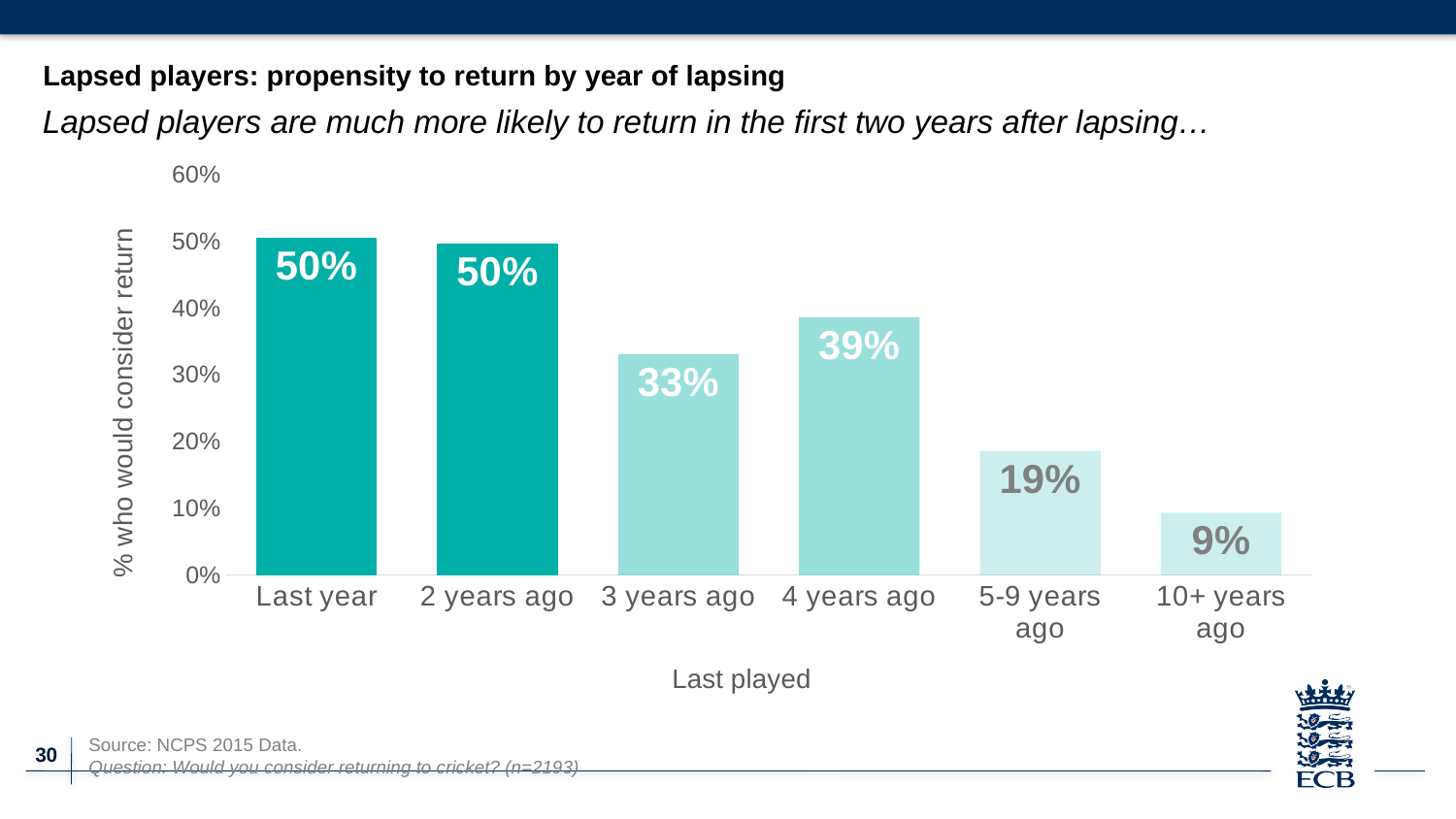
What is the difference between the values for 'Last year' and '10+ years ago'? 41% How many categories are shown on the x axis? 6 Which is larger, the value for '4 years ago' or the value for '5-9 years ago'? 4 years ago Which category has the lowest percentage who would consider returning? 10+ years ago What is the label of the y axis? % who would consider return What kind of chart is shown on the slide? Bar chart What is the value for the '10+ years ago' category? 9% What is the difference between the values for '4 years ago' and '3 years ago'? 6% What is the value for the '5-9 years ago' category? 19% Is the value for '4 years ago' greater or less than 30%? greater What is the label of the x axis? Last played What percentage of lapsed players who last played 3 years ago would consider returning? 33%